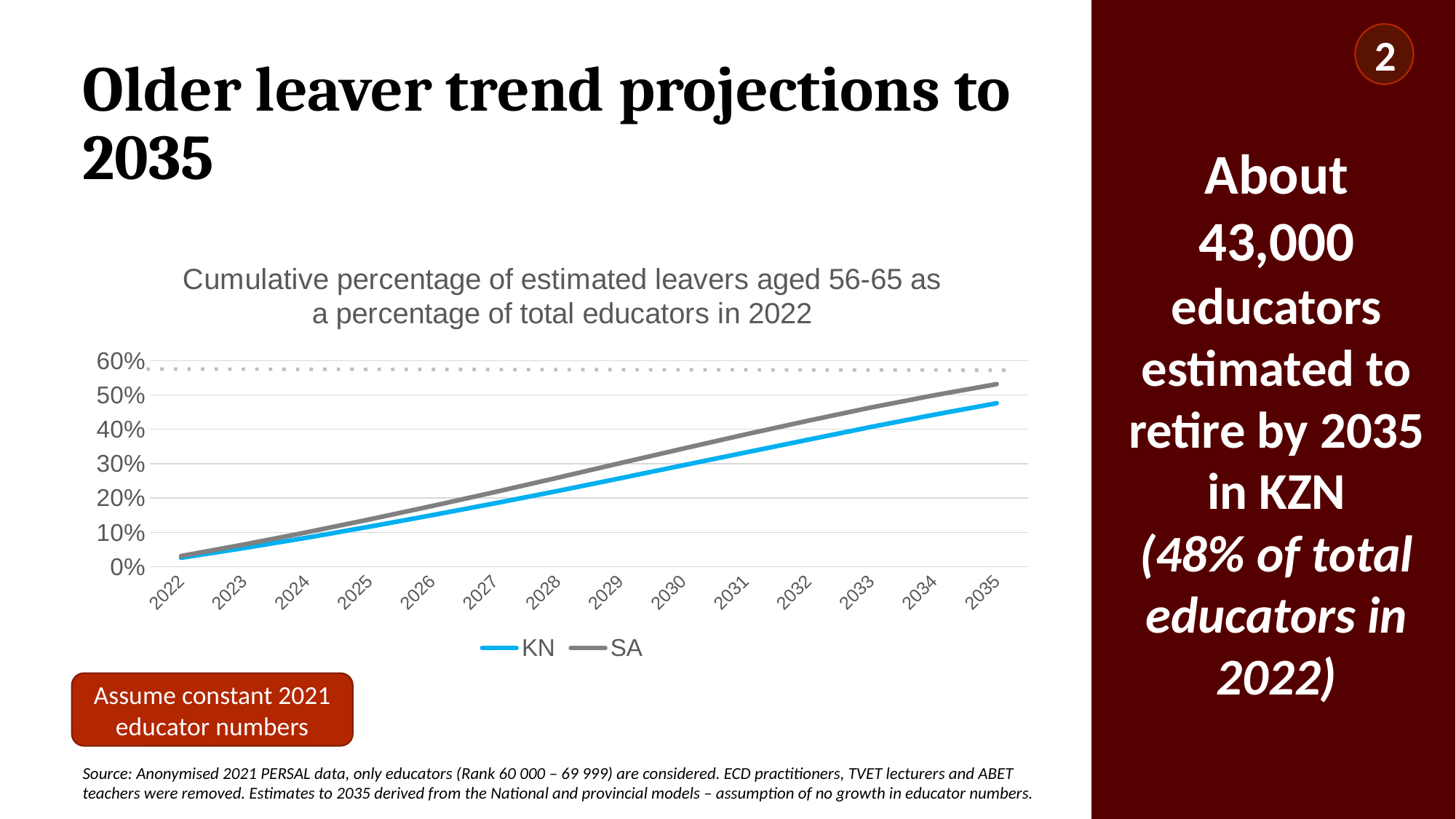
In 2035, which series has the higher value, KN or SA? SA How many series does the chart legend list? 2 How many years are plotted along the x axis of the chart? 14 Is the value for SA in 2035 greater or less than 60%? less Do the values for KN rise or fall from 2022 to 2035? rise Is the value for KN in 2035 greater or less than 40%? greater Is the value for KN in 2022 greater or less than 10%? less What are the two series named in the chart legend? KN and SA What is the title of the chart? Cumulative percentage of estimated leavers aged 56-65 as a percentage of total educators in 2022 Do the values for SA rise or fall from 2022 to 2035? rise What kind of chart is shown on the slide? line chart